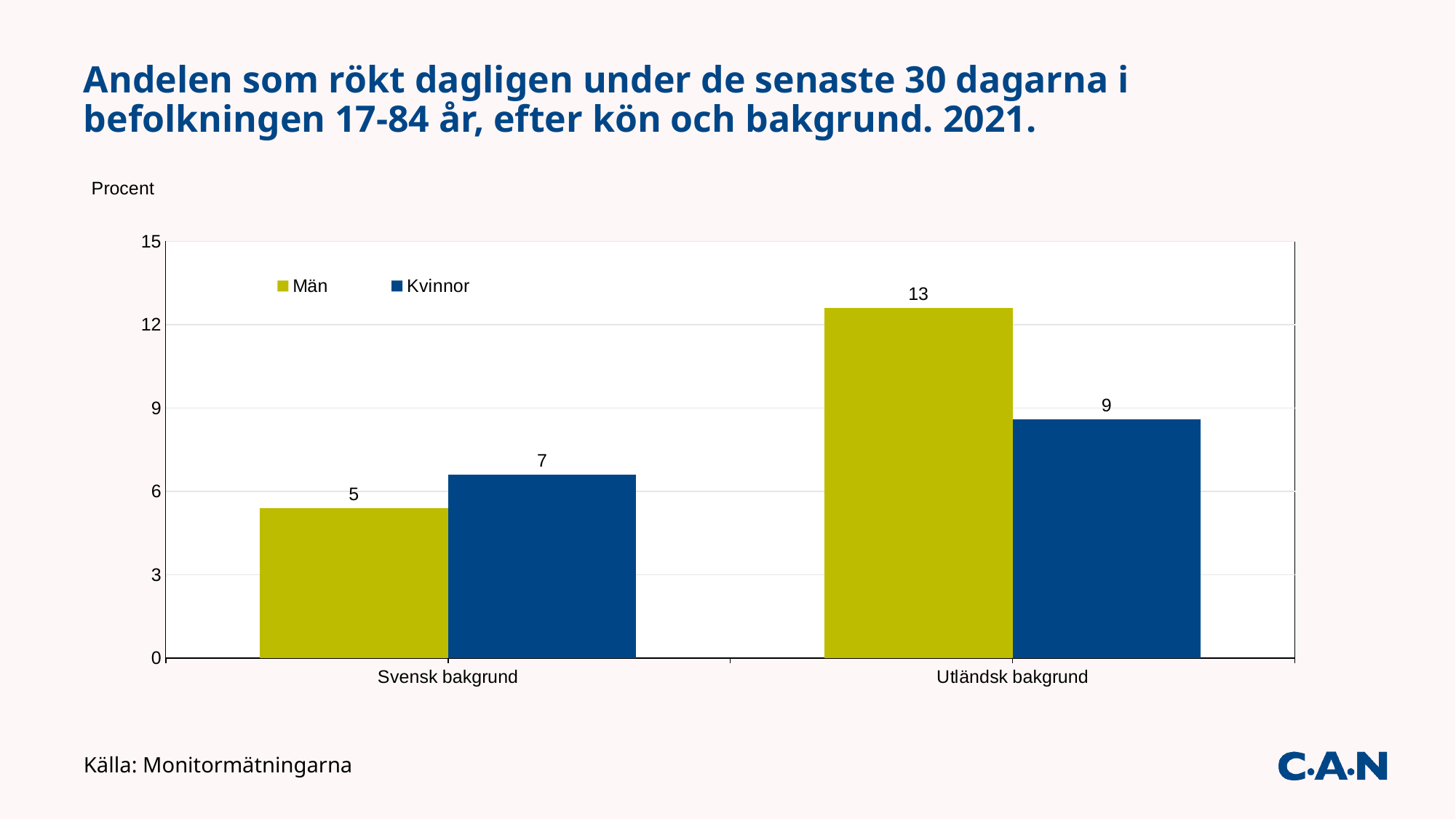
What kind of chart is shown on the slide? Bar chart How many series does the legend list? 2 What is the value for Män in the Svensk bakgrund category? 5 What is the value for Män in the Utländsk bakgrund category? 13 How many categories are shown on the x axis? 2 What is the value for Kvinnor in the Utländsk bakgrund category? 9 Which is larger in the Svensk bakgrund category: Män or Kvinnor? Kvinnor Which bar has the lowest value on the chart? Män, Svensk bakgrund Which bar has the highest value on the chart? Män, Utländsk bakgrund What is the difference between the Män values for Utländsk bakgrund and Svensk bakgrund? 8 What is the source given below the chart? Monitormätningarna Is the value for Kvinnor in Utländsk bakgrund greater or less than 6? greater